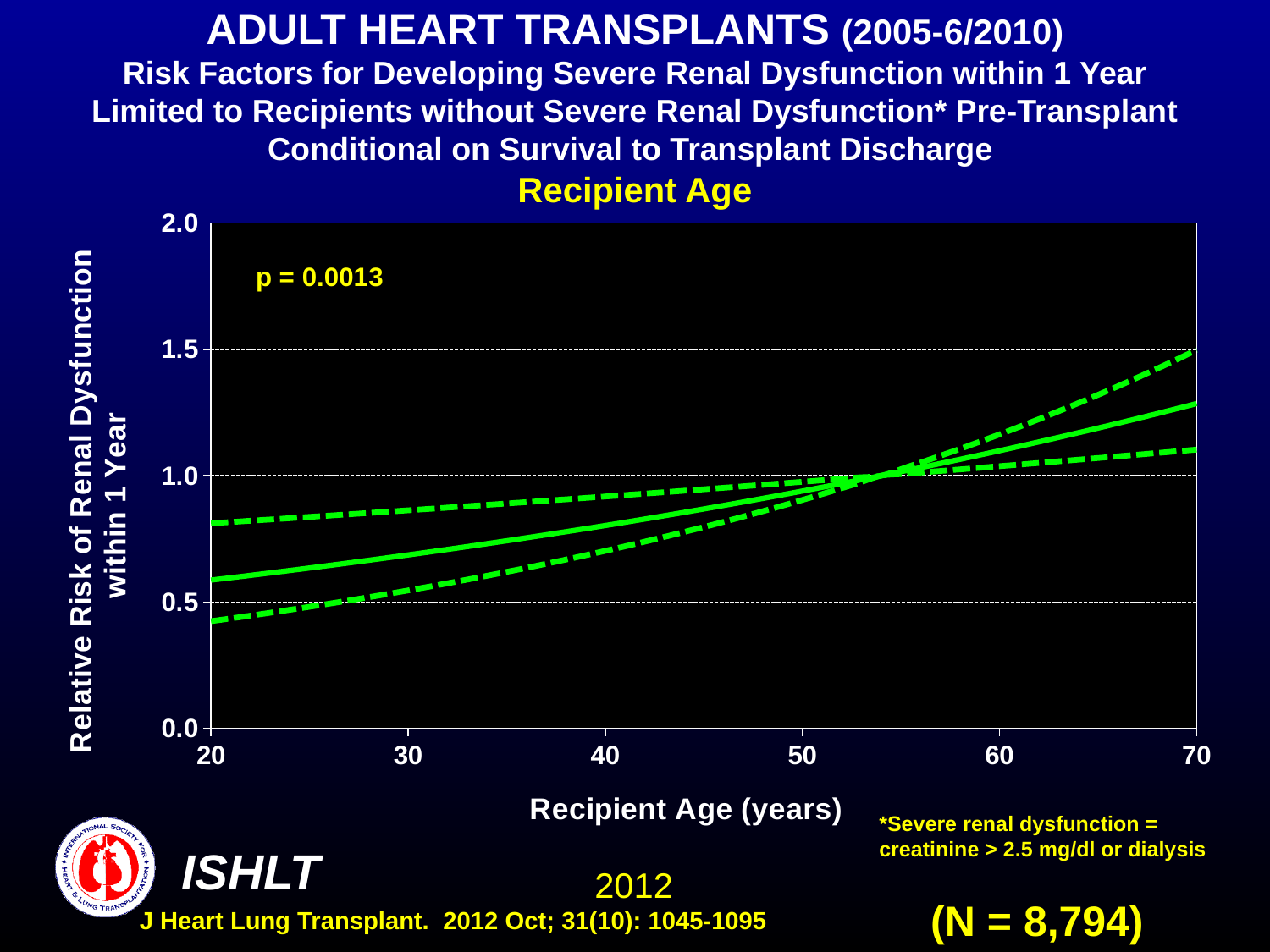
Is the relative risk shown by the solid line at recipient age 20 greater or less than 0.5? greater What is the sample size (N) shown on the slide? N = 8,794 Is the relative risk shown by the solid line at recipient age 20 greater or less than 1.0? less What kind of chart is shown on the slide? line chart Which is larger, the relative risk on the solid line at age 70 or at age 20? age 70 Is the relative risk shown by the lower dashed line at recipient age 20 greater or less than 0.5? less Does the relative risk of renal dysfunction rise or fall as recipient age increases along the x axis? rise How many lines are plotted on the chart? 3 What is the label of the x axis? Recipient Age (years) What p-value is printed on the chart? p = 0.0013